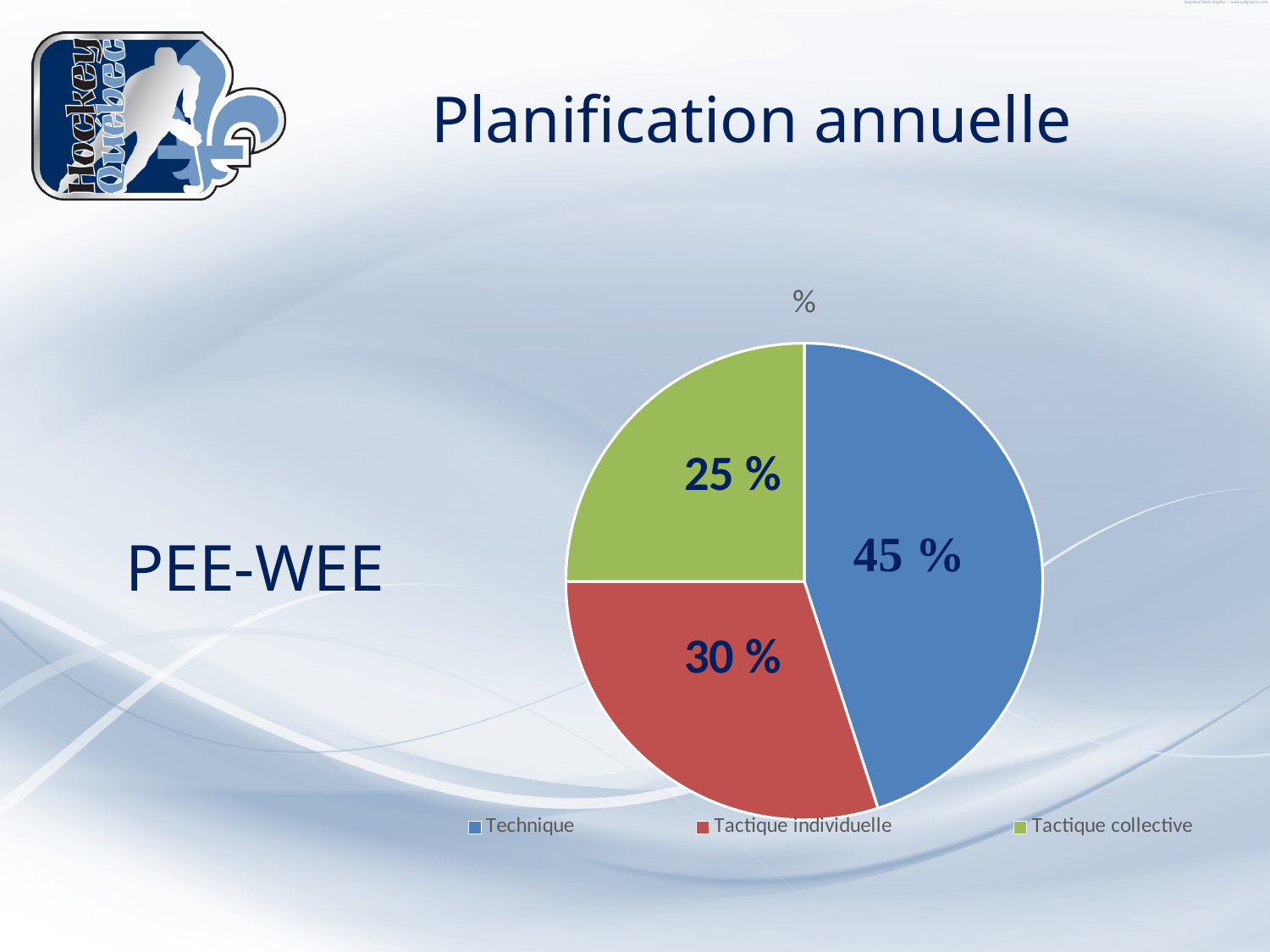
Which is larger, Tactique individuelle or Tactique collective? Tactique individuelle How many entries does the legend list? 3 Which category has the largest slice? Technique What is the value for Tactique collective? 25 % How many slices does the pie chart have? 3 What kind of chart is shown on the slide? pie chart What is the difference between the values for Tactique individuelle and Tactique collective? 5 % What is the difference between the values for Technique and Tactique collective? 20 % What colour is the Tactique individuelle slice? red What is the value for Tactique individuelle? 30 % Which category has the smallest slice? Tactique collective What is the value for Technique? 45 %